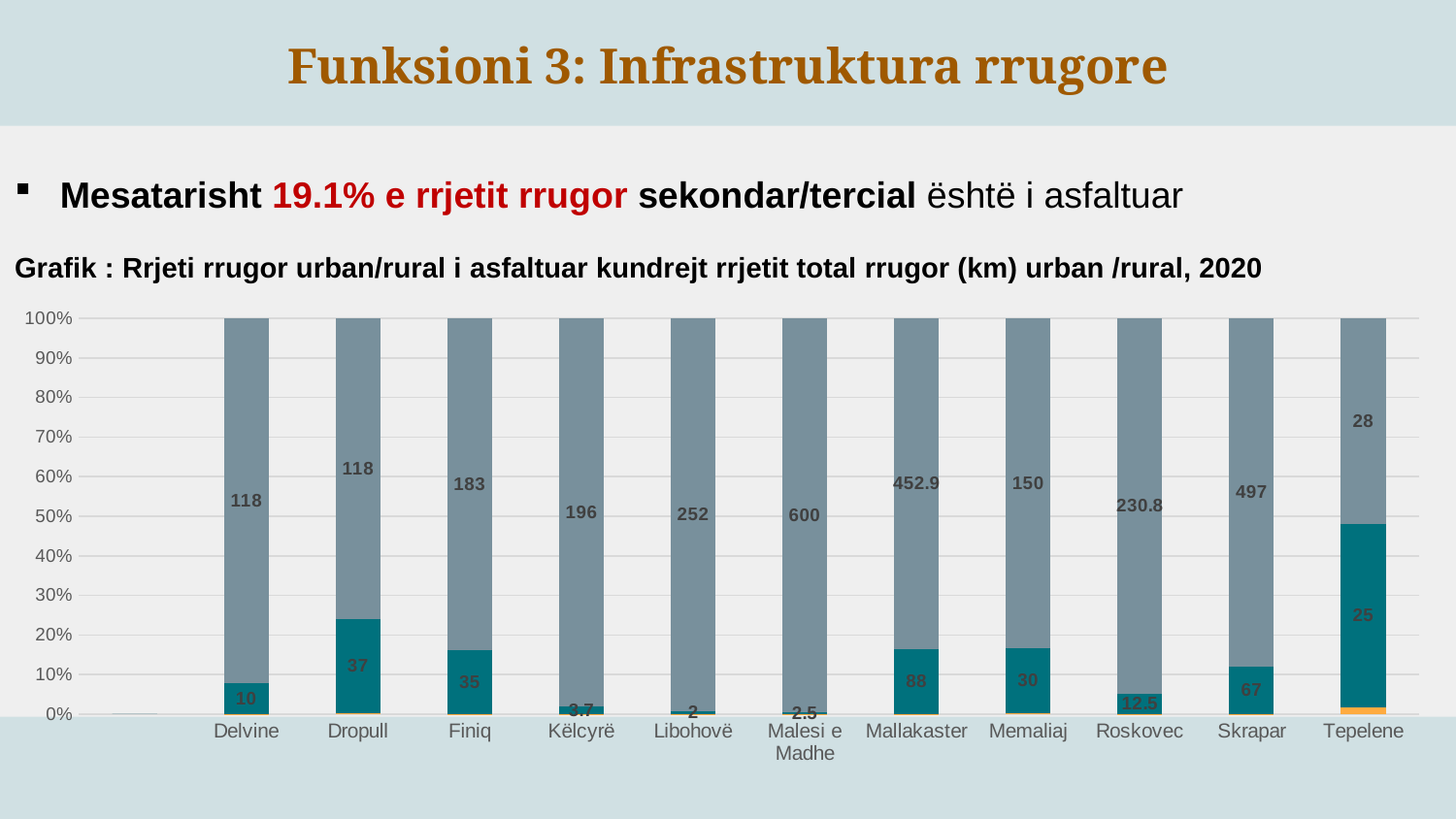
What is the teal (asphalted) data label for Mallakaster? 88 Is the teal (asphalted) segment for Tepelene greater or less than 40% of its bar? greater Which has the larger teal data label, Dropull or Finiq? Dropull What is the grey (total road network) data label for Malesi e Madhe? 600 What is the teal data label shown for Këlcyrë? 3.7 Which municipality has the lowest teal (asphalted) data label? Libohovë What is the difference between the grey data labels for Skrapar and Mallakaster? 44.1 What kind of chart is shown on the slide? Stacked bar chart What year does the chart title say the data refers to? 2020 Which municipality has the highest grey (total road network) data label? Malesi e Madhe How many municipalities are shown on the x axis of the chart? 11 What is the grey data label shown for Roskovec? 230.8